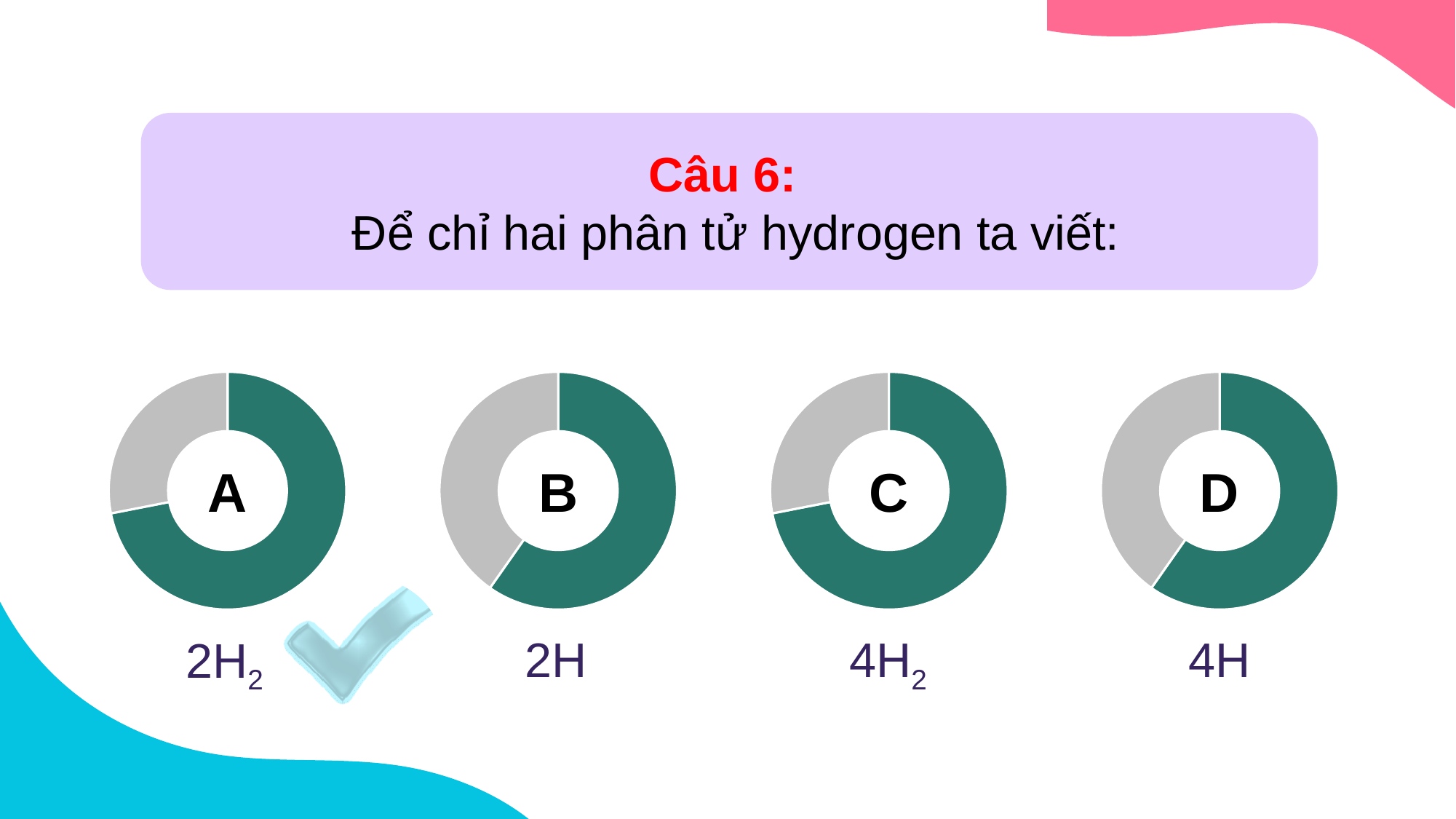
In the chart labelled C, which segment is larger, the green one or the grey one? green In the chart labelled B, which segment is larger, the green one or the grey one? green What letter is printed in the centre of the leftmost donut chart? A How many segments does the chart labelled A have? 2 What text appears below the chart labelled C? 4H₂ What kind of chart is the chart labelled A? donut chart How many donut charts are shown on the slide? 4 In the chart labelled D, which segment is smaller, the green one or the grey one? grey